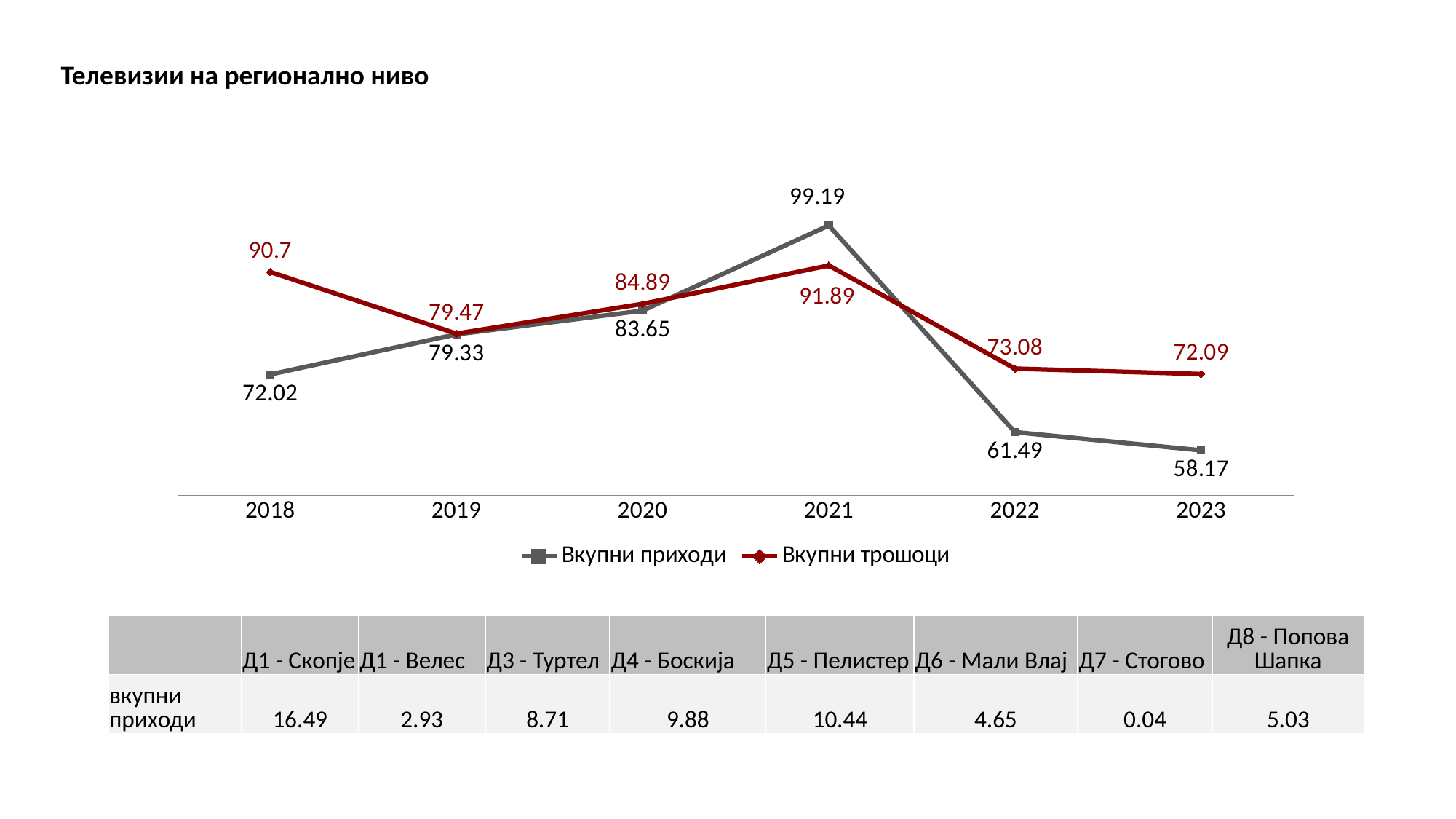
In which year is Вкупни трошоци at its highest? 2021 Which series has the larger value in 2021, Вкупни приходи or Вкупни трошоци? Вкупни приходи In which year is Вкупни приходи at its lowest? 2023 What colour is the line for Вкупни трошоци? dark red Does Вкупни приходи rise or fall from 2021 to 2023? fall How many years are plotted along the x axis of the chart? 6 What type of chart is shown on the slide? line chart How many series does the chart legend list? 2 What is the value of Вкупни приходи in 2021? 99.19 What is the value of Вкупни трошоци in 2023? 72.09 What is the difference between Вкупни трошоци and Вкупни приходи in 2018? 18.68 What is the value of Вкупни трошоци in 2018? 90.7